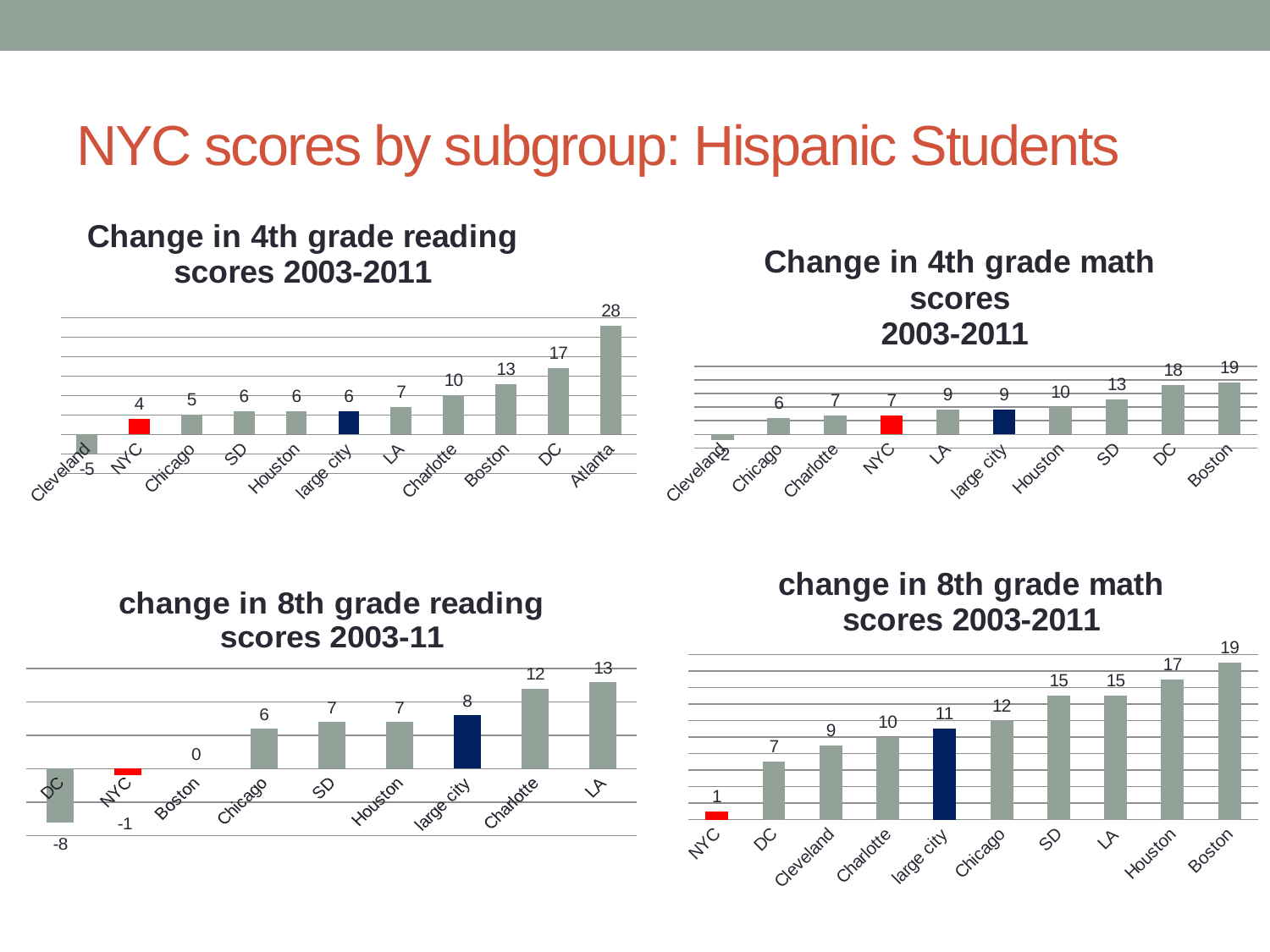
In the 'change in 8th grade math scores 2003-2011' chart, what is the value for large city? 11 In the 'change in 8th grade math scores 2003-2011' chart, what is the difference between Boston and NYC? 18 In the 'Change in 4th grade reading scores 2003-2011' chart, what is the difference between DC and NYC? 13 What type of chart is the 'change in 8th grade math scores 2003-2011' chart? Bar chart In the 'Change in 4th grade reading scores 2003-2011' chart, what is the value for Atlanta? 28 In the 'Change in 4th grade math scores 2003-2011' chart, which city has the highest value? Boston In the 'Change in 4th grade math scores 2003-2011' chart, what is the value for NYC? 7 In the 'change in 8th grade reading scores 2003-11' chart, what is the value for DC? -8 How many categories are shown in the 'Change in 4th grade reading scores 2003-2011' chart? 11 In the 'Change in 4th grade math scores 2003-2011' chart, which is larger, the value for SD or the value for Houston? SD In the 'change in 8th grade reading scores 2003-11' chart, which city has the highest value? LA In the 'Change in 4th grade reading scores 2003-2011' chart, which city has the lowest value? Cleveland